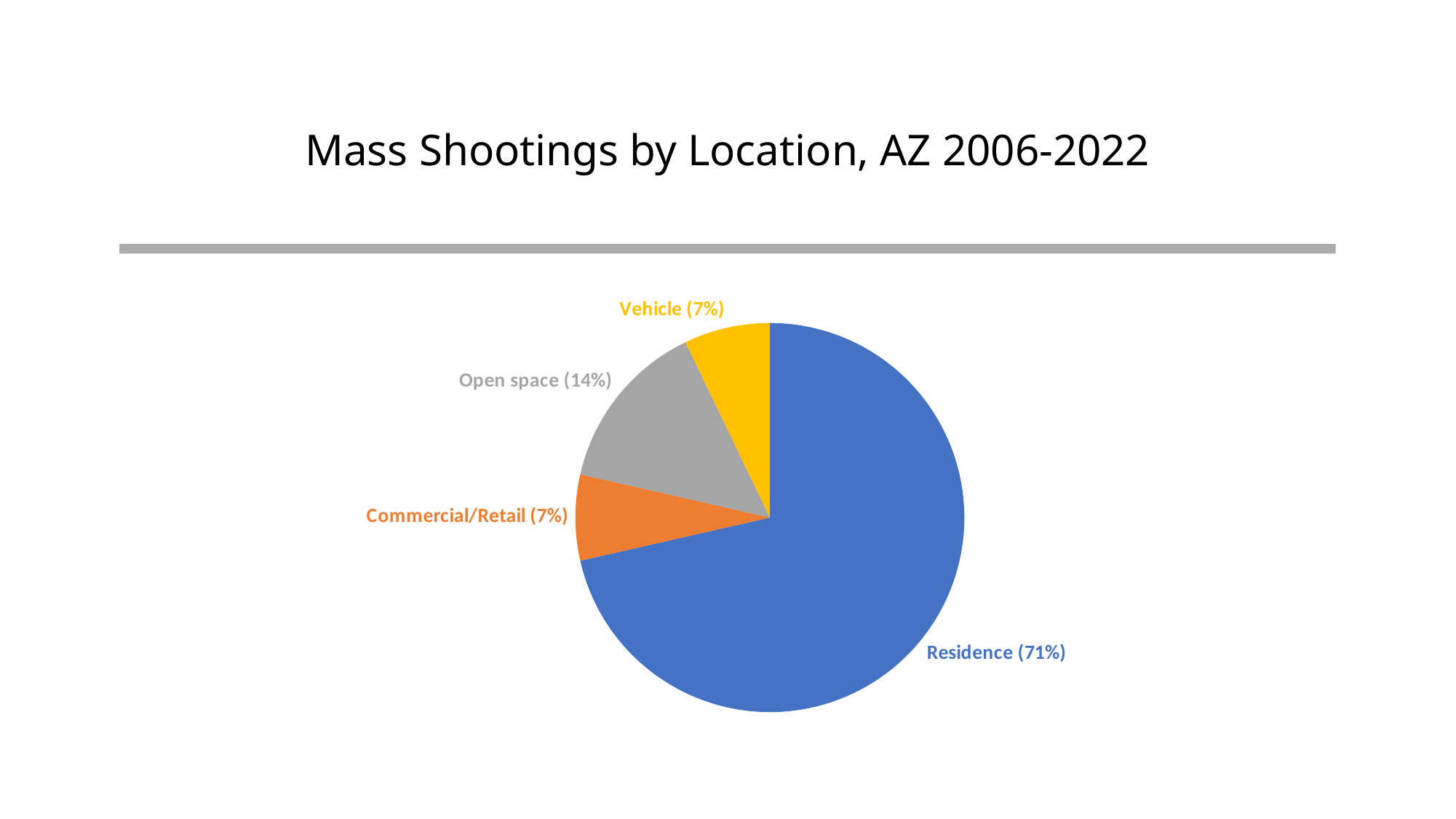
What is the title of the chart? Mass Shootings by Location, AZ 2006-2022 What share of mass shootings occurred in a Vehicle? 7% What colour is the Residence slice? blue Which is larger, the share for Open space or the share for Vehicle? Open space What is the combined share of Open space and Commercial/Retail? 21% What share of mass shootings occurred in Open space? 14% What kind of chart is shown on the slide? pie chart What is the difference in percentage points between the Residence share and the Open space share? 57 How many location categories are shown in the pie chart? 4 Which location has the largest share of mass shootings? Residence What share of mass shootings occurred at a Commercial/Retail location? 7%